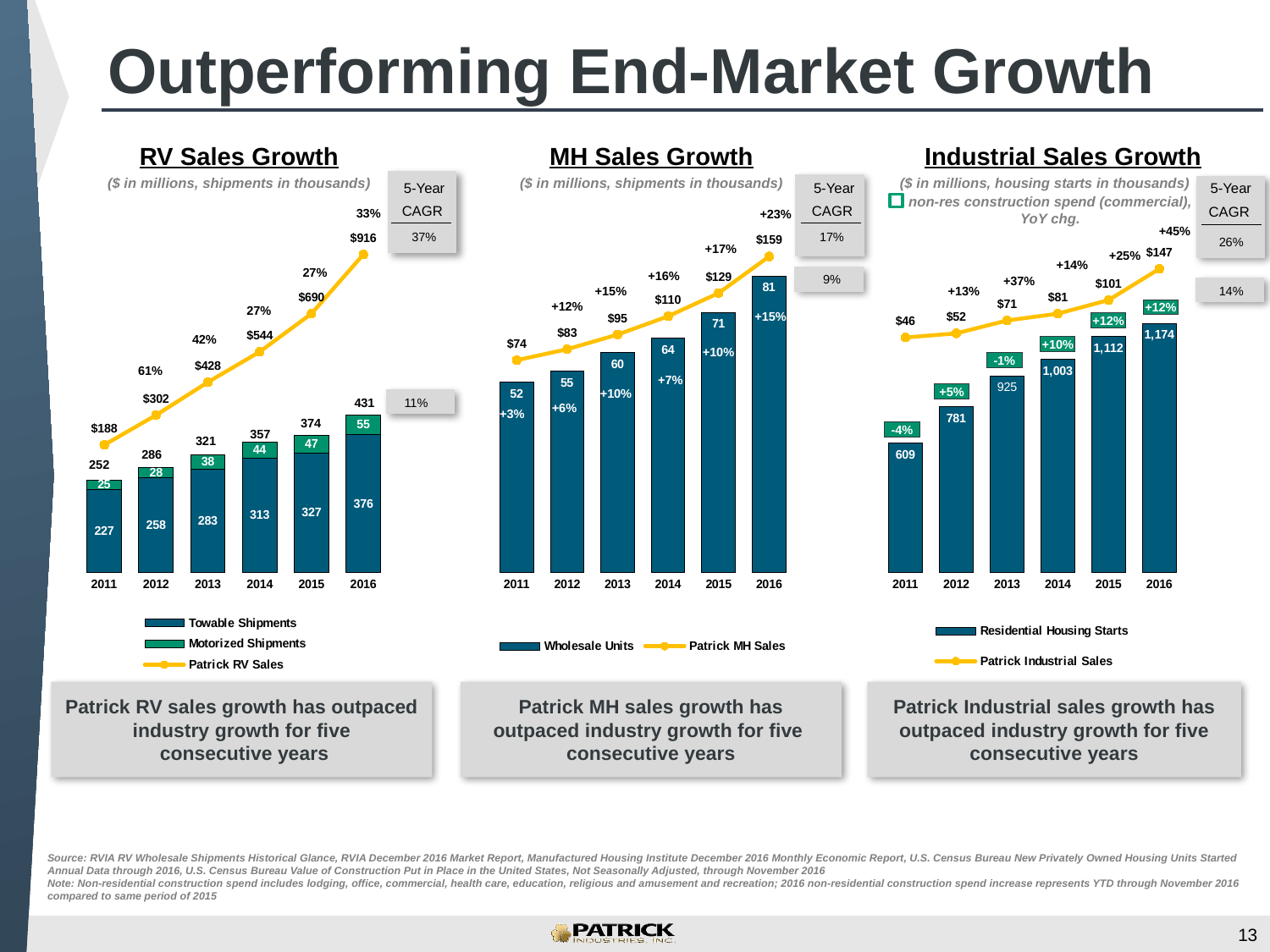
On the RV Sales Growth chart, what is the total of the stacked bar for 2016? 431 On the MH Sales Growth chart, which year has the lowest Patrick MH Sales? 2011 On the MH Sales Growth chart, what is the difference between Patrick MH Sales in 2016 and 2015? $30 On the Industrial Sales Growth chart, which year has the highest Patrick Industrial Sales? 2016 On the MH Sales Growth chart, do Wholesale Units rise or fall from 2011 to 2016? rise On the Industrial Sales Growth chart, what was the value of Residential Housing Starts in 2014? 1,003 On the RV Sales Growth chart, what were Patrick RV Sales in 2016? $916 What kind of chart is the MH Sales Growth chart? Bar chart with a line On the Industrial Sales Growth chart, how many years are shown on the x axis? 6 On the MH Sales Growth chart, what was the value of Wholesale Units in 2013? 60 On the RV Sales Growth chart, what was the value of Towable Shipments in 2014? 313 On the RV Sales Growth chart, how many series does the legend list? 3